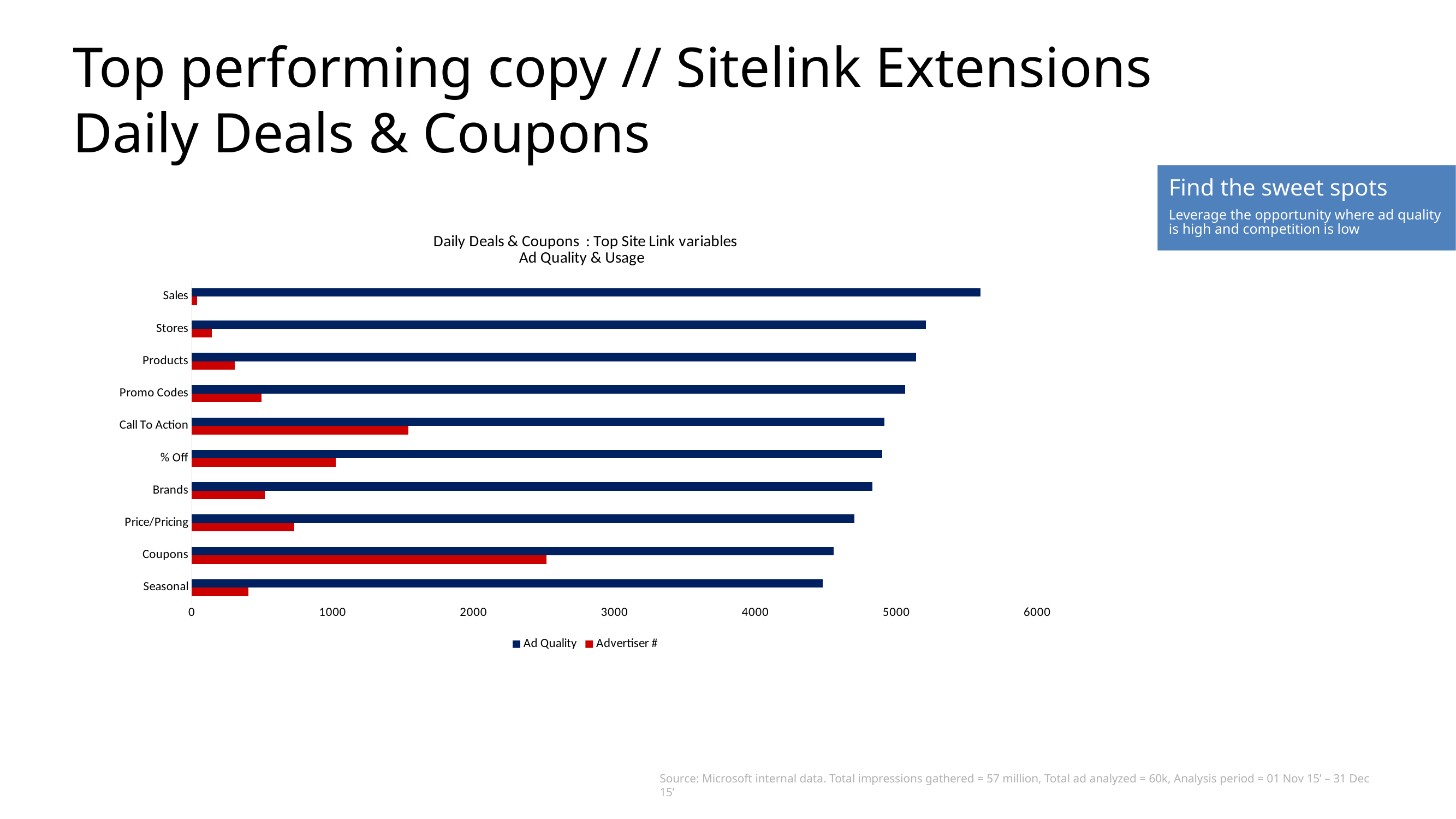
Which colour represents the Advertiser # series in the chart? red How many series does the chart legend list? 2 Which has the larger Advertiser # value, Coupons or Call To Action? Coupons Which category has the highest Advertiser # value? Coupons Is the Ad Quality value for Sales greater or less than 5000? greater How many categories are plotted on the chart? 10 Which category has the highest Ad Quality value? Sales Is the Advertiser # value for Coupons greater or less than 2000? greater Is the Advertiser # value for Call To Action greater or less than 1000? greater What kind of chart is shown on the slide? bar chart Which category has the lowest Advertiser # value? Sales